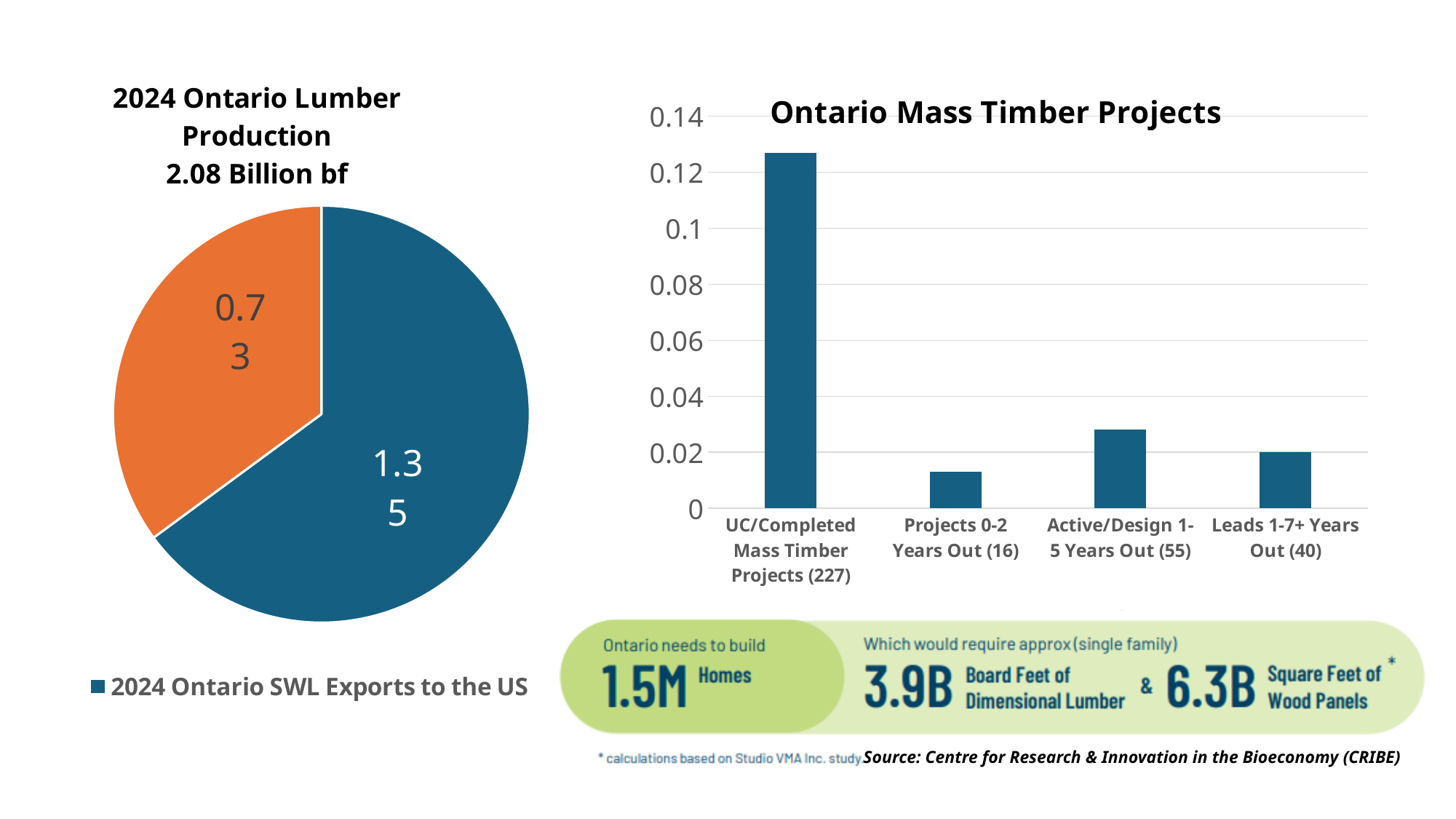
How many categories are shown on the x axis of the 'Ontario Mass Timber Projects' chart? 4 In the 'Ontario Mass Timber Projects' chart, is the value for Projects 0-2 Years Out (16) greater or less than 0.02? less In the pie chart on the left, what is the difference between the two slice values, 1.35 and 0.73? 0.62 In the pie chart titled '2024 Ontario Lumber Production 2.08 Billion bf', what value is shown for 2024 Ontario SWL Exports to the US? 1.35 In the 'Ontario Mass Timber Projects' chart, which category has the lowest bar? Projects 0-2 Years Out (16) In the pie chart on the left, what value is shown on the orange slice? 0.73 In the pie chart on the left, how many slices are there? 2 In the pie chart on the left, which slice is larger: the blue slice (2024 Ontario SWL Exports to the US) or the orange slice? The blue slice (2024 Ontario SWL Exports to the US) What total production figure is stated in the title of the pie chart on the left? 2.08 Billion bf In the 'Ontario Mass Timber Projects' chart, which category has the highest bar? UC/Completed Mass Timber Projects (227) What kind of chart is 'Ontario Mass Timber Projects'? Bar chart In the 'Ontario Mass Timber Projects' chart, is the value for UC/Completed Mass Timber Projects (227) greater or less than 0.12? greater